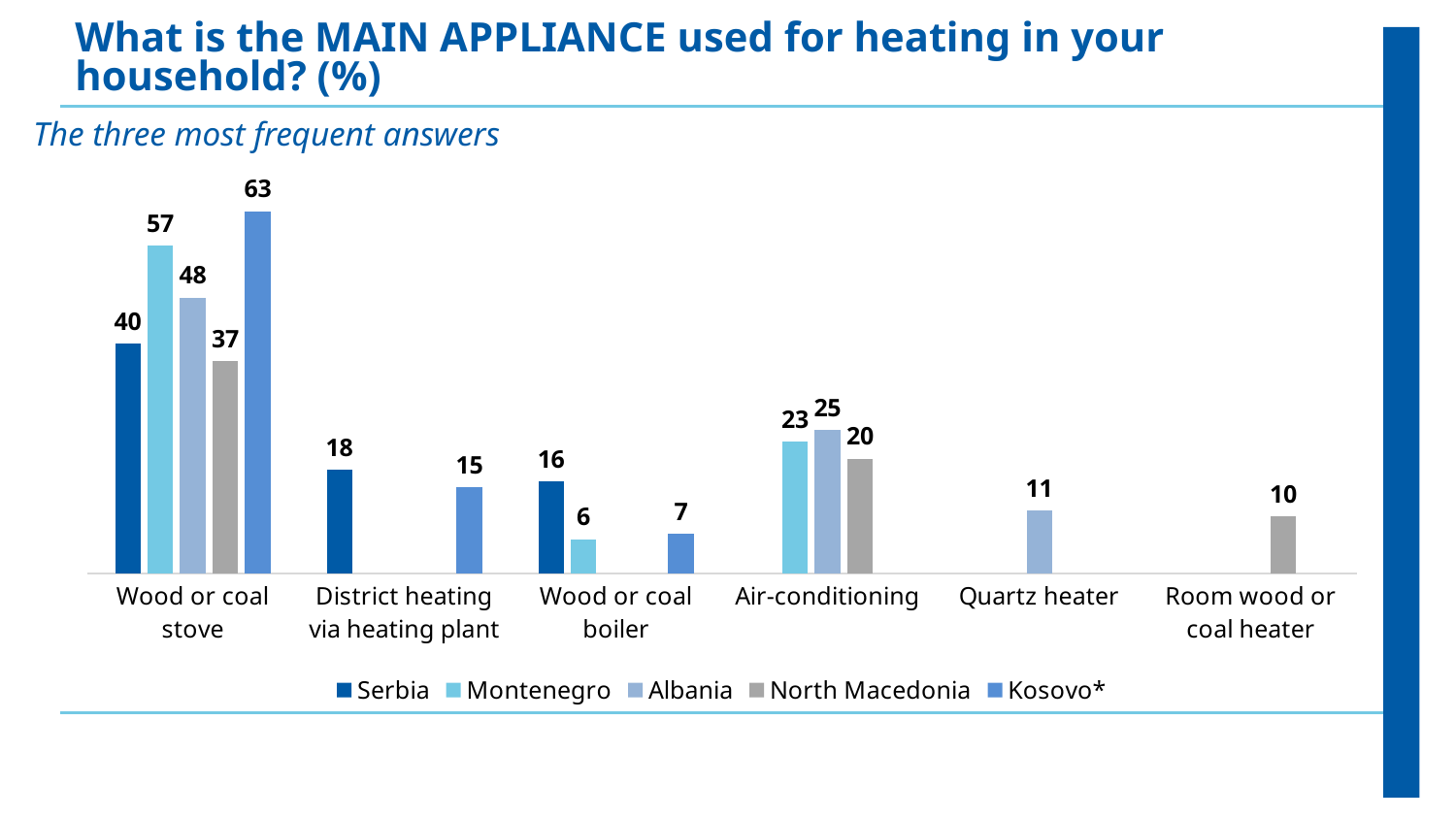
How many appliance categories are shown on the x axis? 6 What kind of chart is shown on the slide? Bar chart Which country is the only one with a value shown for Quartz heater? Albania What is the value for North Macedonia in the Room wood or coal heater category? 10 What is the value for Kosovo* in the Wood or coal stove category? 63 What is the value for North Macedonia in the Air-conditioning category? 20 Which country has the highest value in the Wood or coal stove category? Kosovo* Which is larger in the Air-conditioning category: Albania or Montenegro? Albania Which country has the lowest value in the Wood or coal boiler category? Montenegro How many series does the legend list? 5 What is the difference between Montenegro and Serbia in the Wood or coal stove category? 17 What is the value for Serbia in the District heating via heating plant category? 18